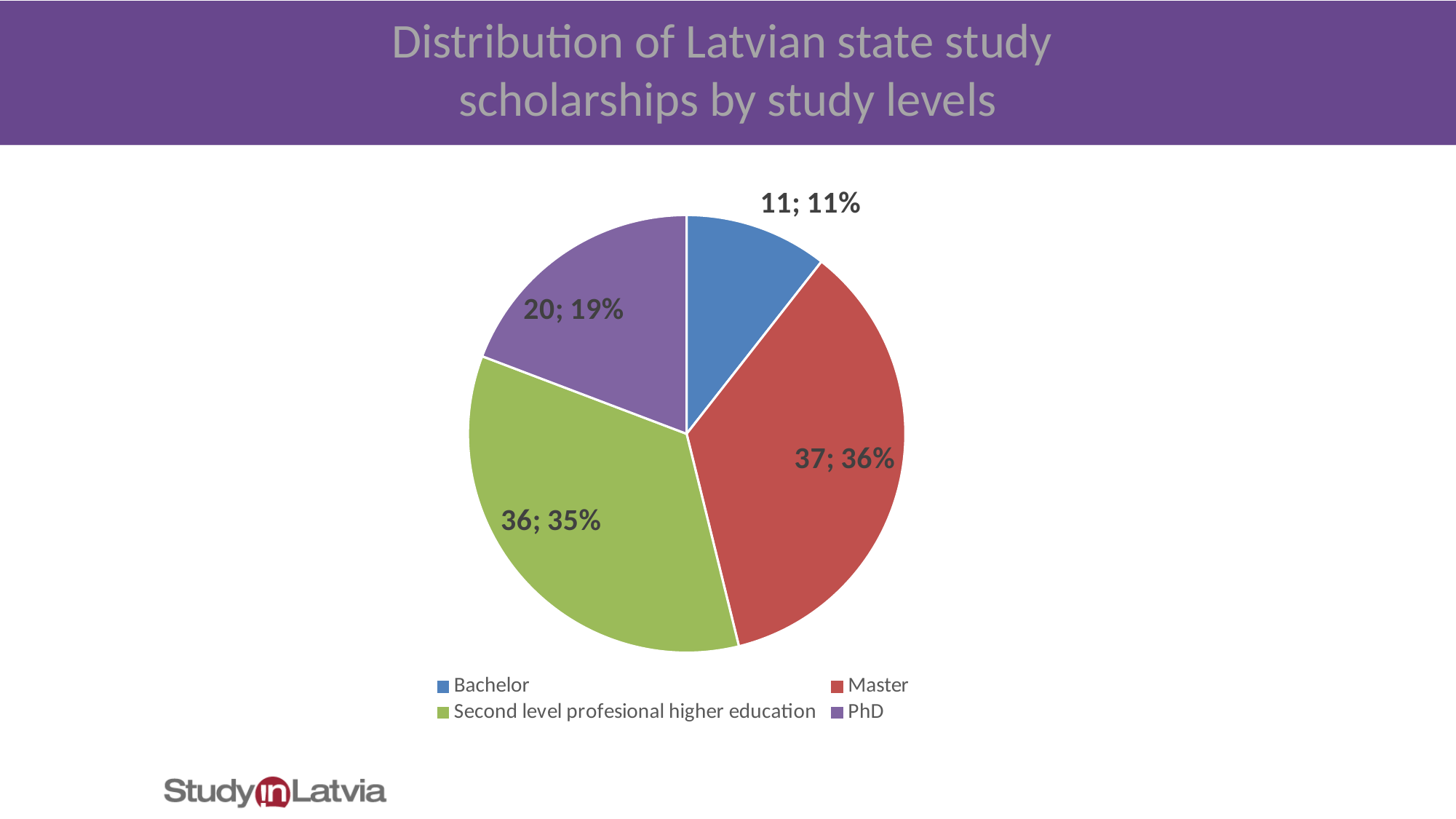
Which study level has the largest number of scholarships? Master What is the title of the chart? Distribution of Latvian state study scholarships by study levels How many scholarships are shown for Bachelor level? 11 What is the difference in scholarships between PhD and Bachelor? 9 Which study level has the smallest number of scholarships? Bachelor What share of the pie does Second level profesional higher education take? 35% What is the total number of scholarships across all study levels? 104 Which has more scholarships, PhD or Bachelor? PhD How many study levels are shown in the pie chart? 4 What percentage of scholarships goes to Master level? 36% What kind of chart is shown on the slide? pie chart How many scholarships are shown for PhD level? 20